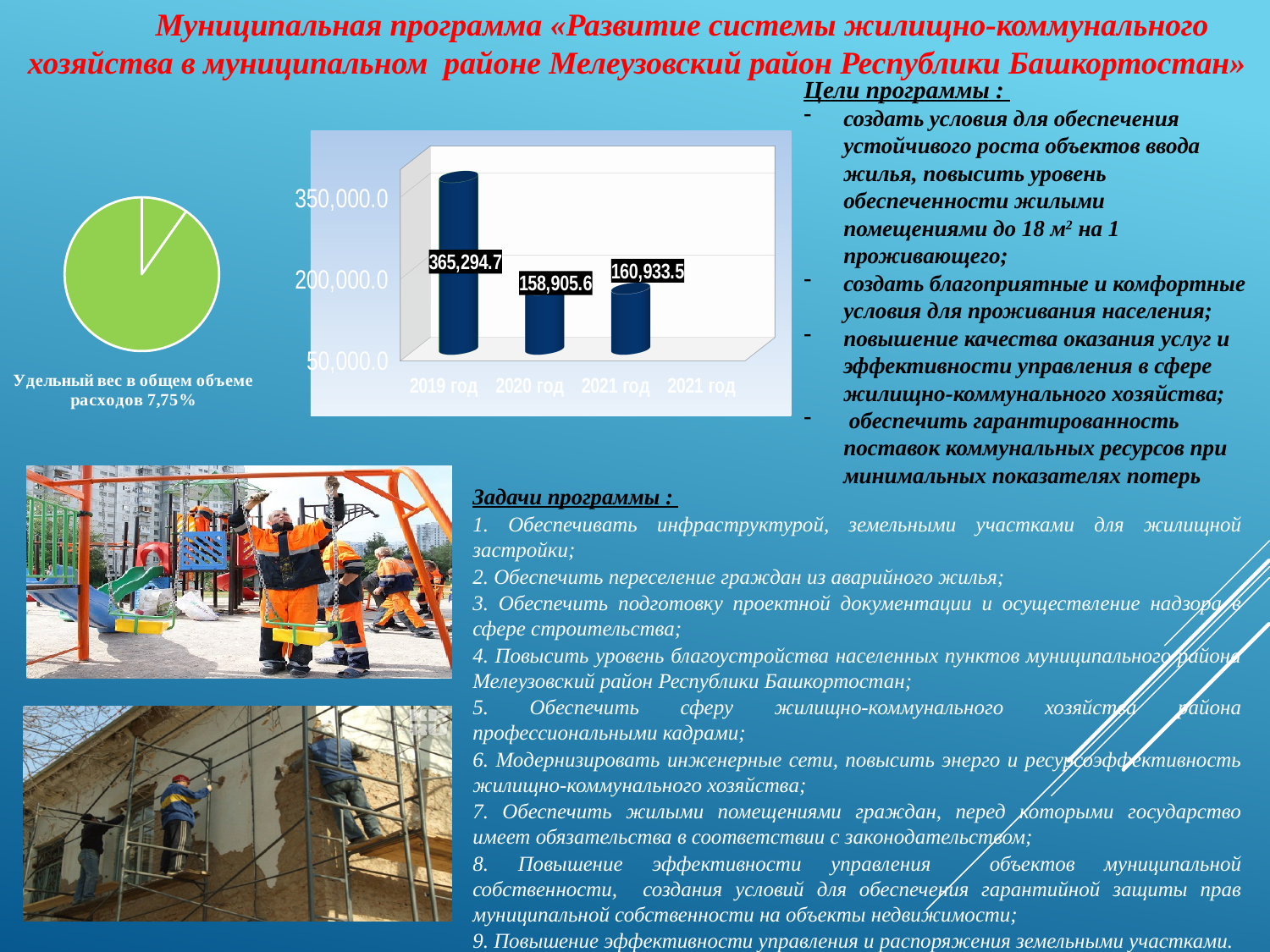
In the bar chart, which year has the lowest value? 2020 год What kind of chart is shown on the left of the slide above the caption 'Удельный вес в общем объеме расходов'? pie chart In the bar chart, is the value for 2020 год greater or less than 200,000.0? less How many bars are plotted in the bar chart? 3 What kind of chart is the chart in the centre of the slide showing values by year? bar chart In the bar chart, what is the value of the third bar (2021 год)? 160,933.5 In the bar chart, what is the value for 2020 год? 158,905.6 In the bar chart, what is the value for 2019 год? 365,294.7 In the bar chart, which is larger: the value for 2019 год or the value for 2020 год? 2019 год In the bar chart, what is the difference between the values for 2019 год and 2020 год? 206,389.1 In the bar chart, what is the difference between the values for 2021 год and 2020 год? 2,027.9 In the bar chart, which year has the highest value? 2019 год